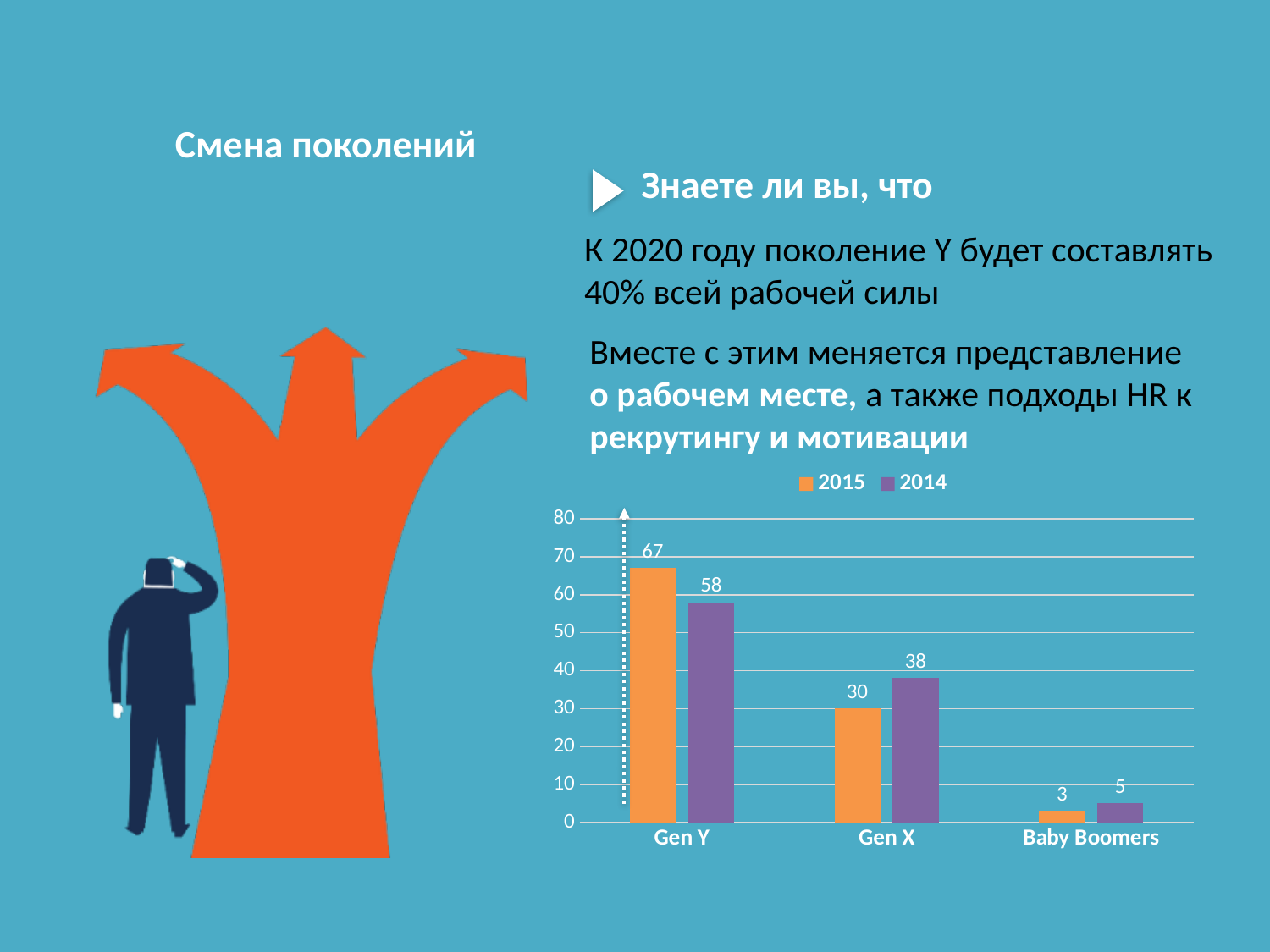
Which category has the lowest 2015 value? Baby Boomers Which is larger for Gen X: the 2015 value or the 2014 value? 2014 What is the 2015 value for Baby Boomers? 3 Which category has the highest 2014 value? Gen Y What kind of chart is shown on the slide? bar chart Which colour represents the 2015 series in the chart? orange What is the difference between the 2015 and 2014 values for Gen Y? 9 What is the difference between the 2014 and 2015 values for Gen X? 8 What is the 2014 value for Gen X? 38 What is the 2015 value for Gen Y? 67 How many series does the legend list? 2 How many categories are shown on the x axis? 3